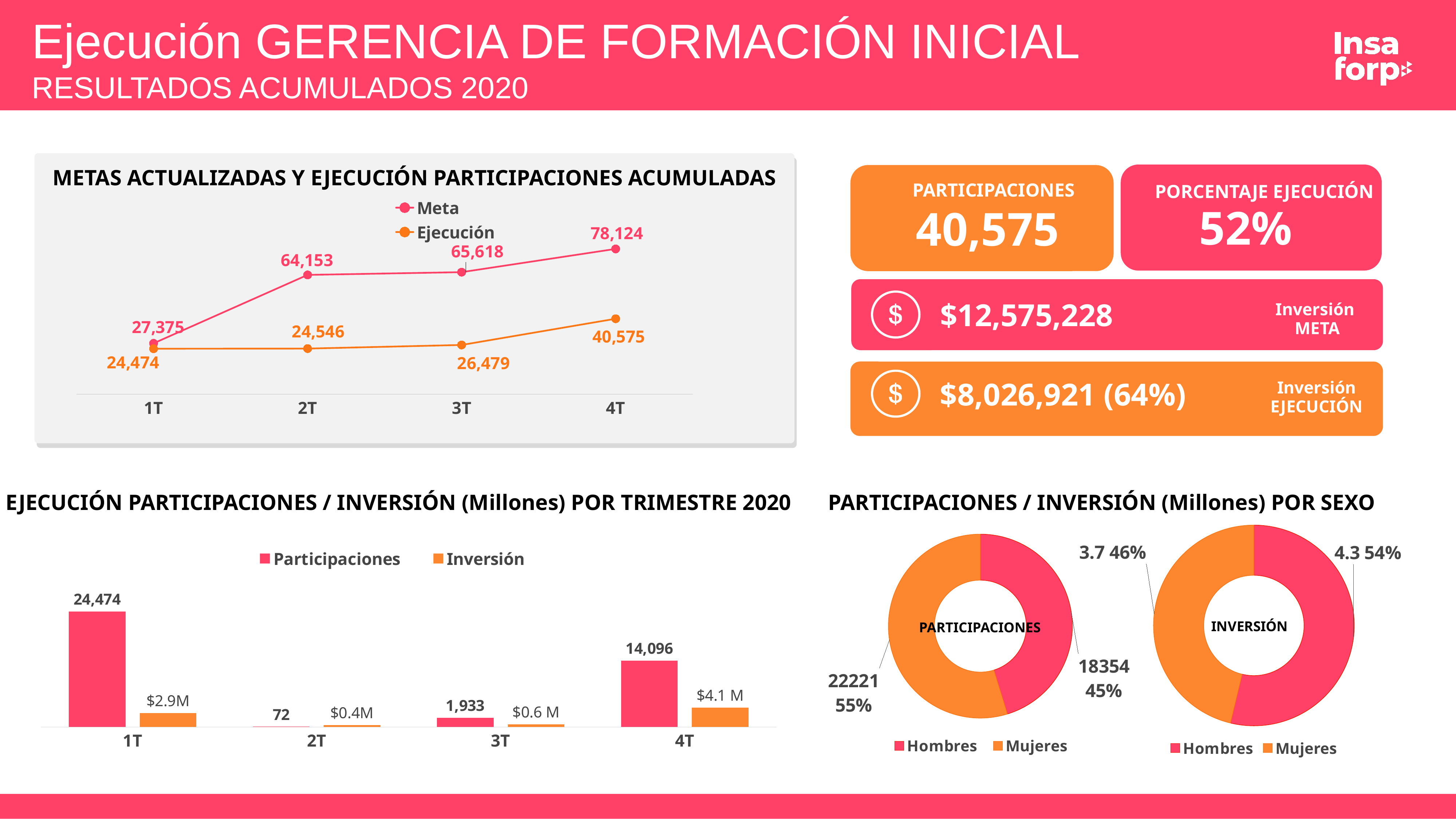
In the chart 'Metas actualizadas y ejecución participaciones acumuladas', does the Meta series rise or fall from 1T to 4T? rises In the chart 'Ejecución participaciones / inversión (Millones) por trimestre 2020', what is the Inversión value for 4T? $4.1 M How many series does the legend of 'Metas actualizadas y ejecución participaciones acumuladas' list? 2 In the chart 'Ejecución participaciones / inversión (Millones) por trimestre 2020', what is the Participaciones value for 3T? 1,933 In the chart 'Ejecución participaciones / inversión (Millones) por trimestre 2020', which quarter has the lowest Participaciones value? 2T In the chart 'Metas actualizadas y ejecución participaciones acumuladas', what is the Meta value at 4T? 78,124 In the chart 'Metas actualizadas y ejecución participaciones acumuladas', what is the Ejecución value at 3T? 26,479 In the Inversión donut chart under 'Participaciones / inversión (Millones) por sexo', what is the value for Hombres? 4.3 In the Participaciones donut chart under 'Participaciones / inversión (Millones) por sexo', what share do Mujeres have? 55% In the chart 'Metas actualizadas y ejecución participaciones acumuladas', what is the difference between Meta and Ejecución at 4T? 37,549 What kind of chart is 'Metas actualizadas y ejecución participaciones acumuladas'? line chart How many quarters are shown on the x axis of 'Ejecución participaciones / inversión (Millones) por trimestre 2020'? 4